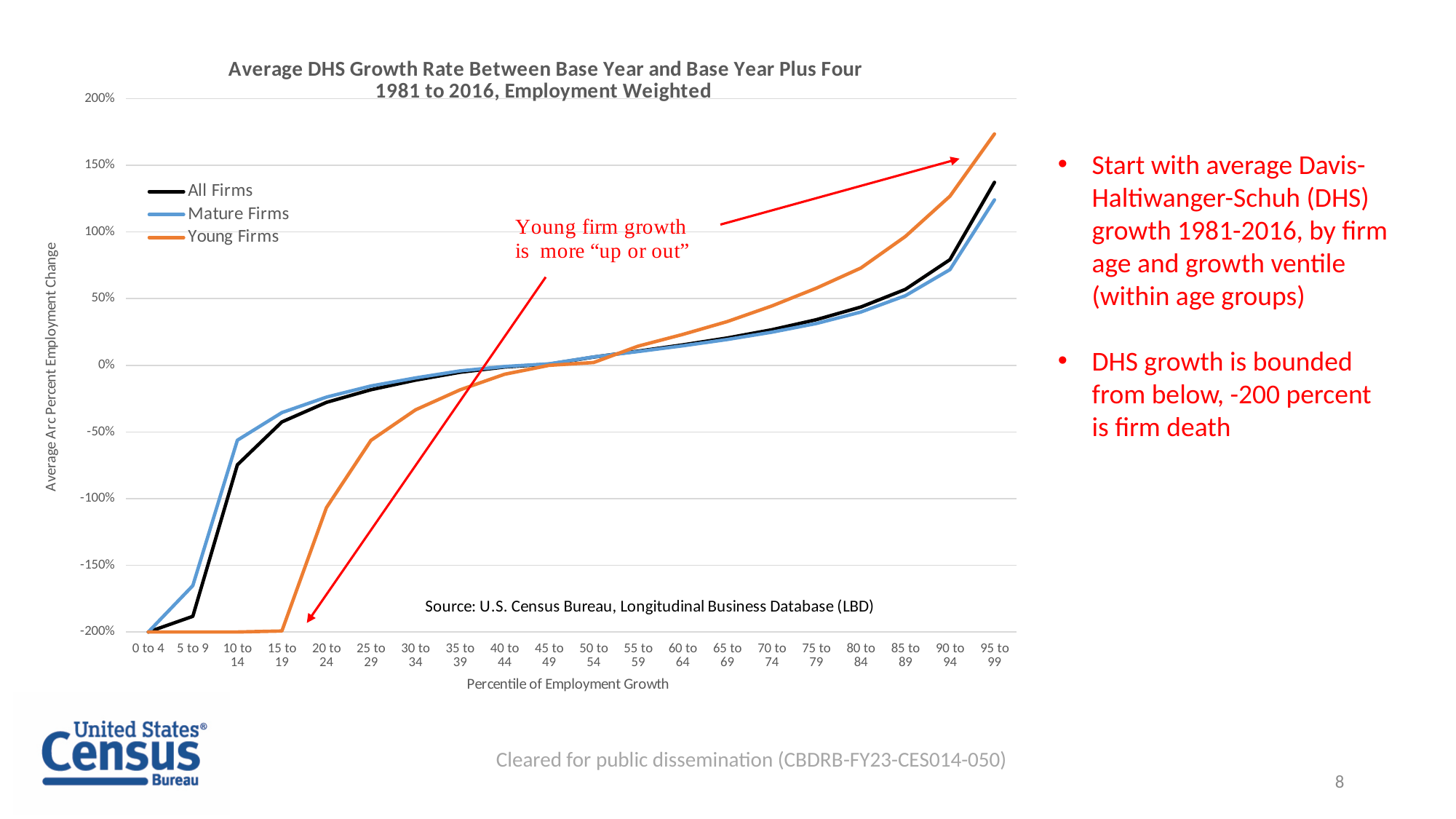
What is the value for Young Firms at the 0 to 4 percentile? -200% What kind of chart is shown on the slide? line chart At the 95 to 99 percentile, which is larger: Young Firms or Mature Firms? Young Firms Do the values for All Firms rise or fall as the percentile increases along the x axis? rise Is the value for All Firms at the 10 to 14 percentile greater or less than -50%? less Is the value for Young Firms at the 95 to 99 percentile greater or less than 150%? greater At the 10 to 14 percentile, which is larger: Mature Firms or Young Firms? Mature Firms How many series does the legend list? 3 Is the value for Mature Firms at the 95 to 99 percentile greater or less than 150%? less How many percentile categories are shown along the x axis? 20 Which series has the lowest value at the 20 to 24 percentile? Young Firms